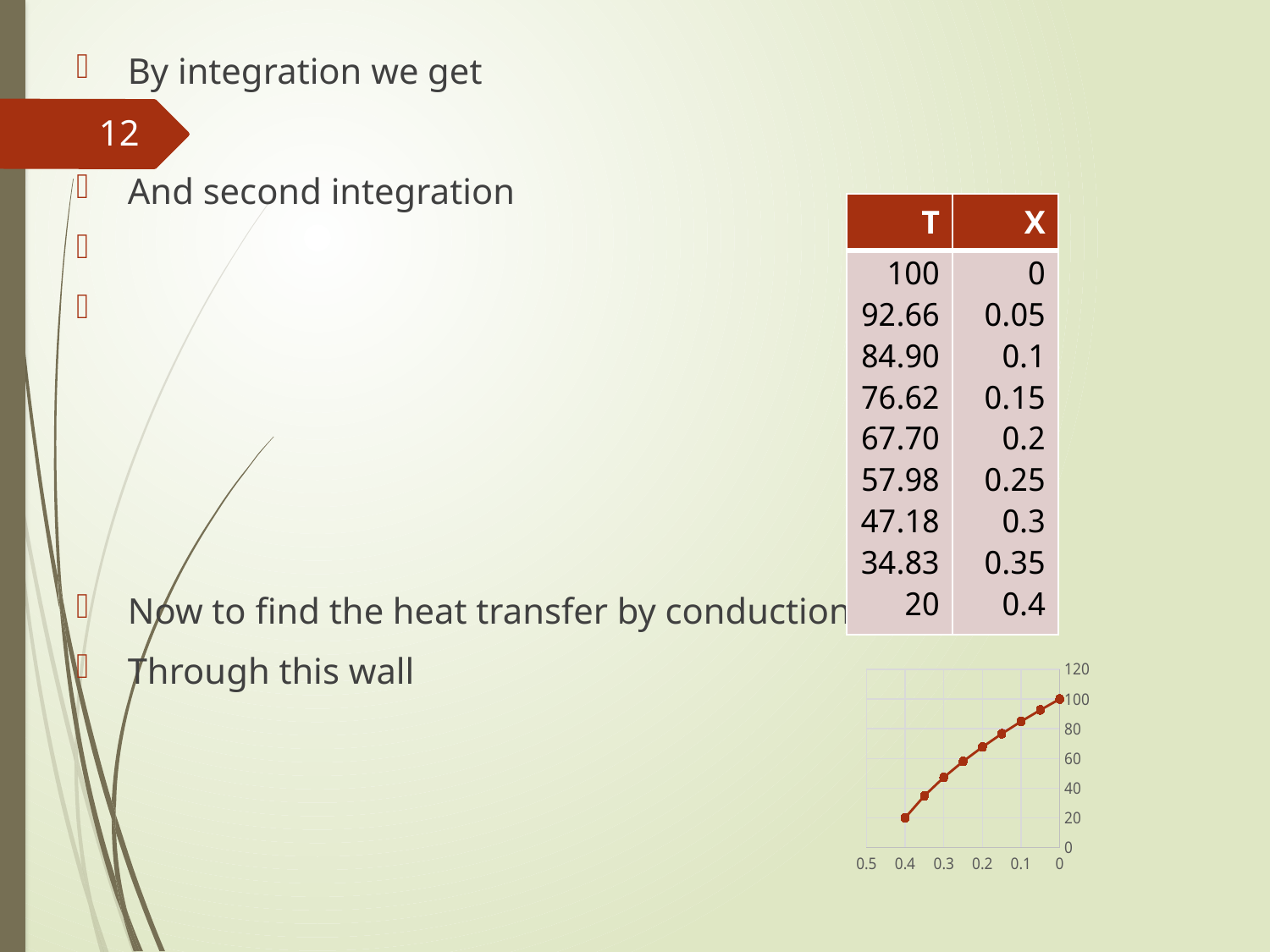
On the chart at the bottom right, at which x value is the plotted value lowest? 0.4 What kind of chart is shown at the bottom right of the slide? line chart On the chart at the bottom right, what is the difference between the plotted value at x = 0 and the plotted value at x = 0.4? 80 On the chart at the bottom right, which has the larger plotted value: x = 0.1 or x = 0.3? x = 0.1 How many data points are plotted on the chart at the bottom right of the slide? 9 On the chart at the bottom right, is the plotted value at x = 0.2 greater or less than 60? greater On the chart at the bottom right, moving from left to right along the x axis, do the plotted values rise or fall? rise On the chart at the bottom right, at which x value is the plotted value highest? 0 What is the highest value shown on the vertical axis of the chart at the bottom right? 120 On the chart at the bottom right, is the plotted value at x = 0.3 greater or less than 60? less On the chart at the bottom right, what is the plotted value at x = 0.4? 20 On the chart at the bottom right, what is the plotted value at x = 0? 100